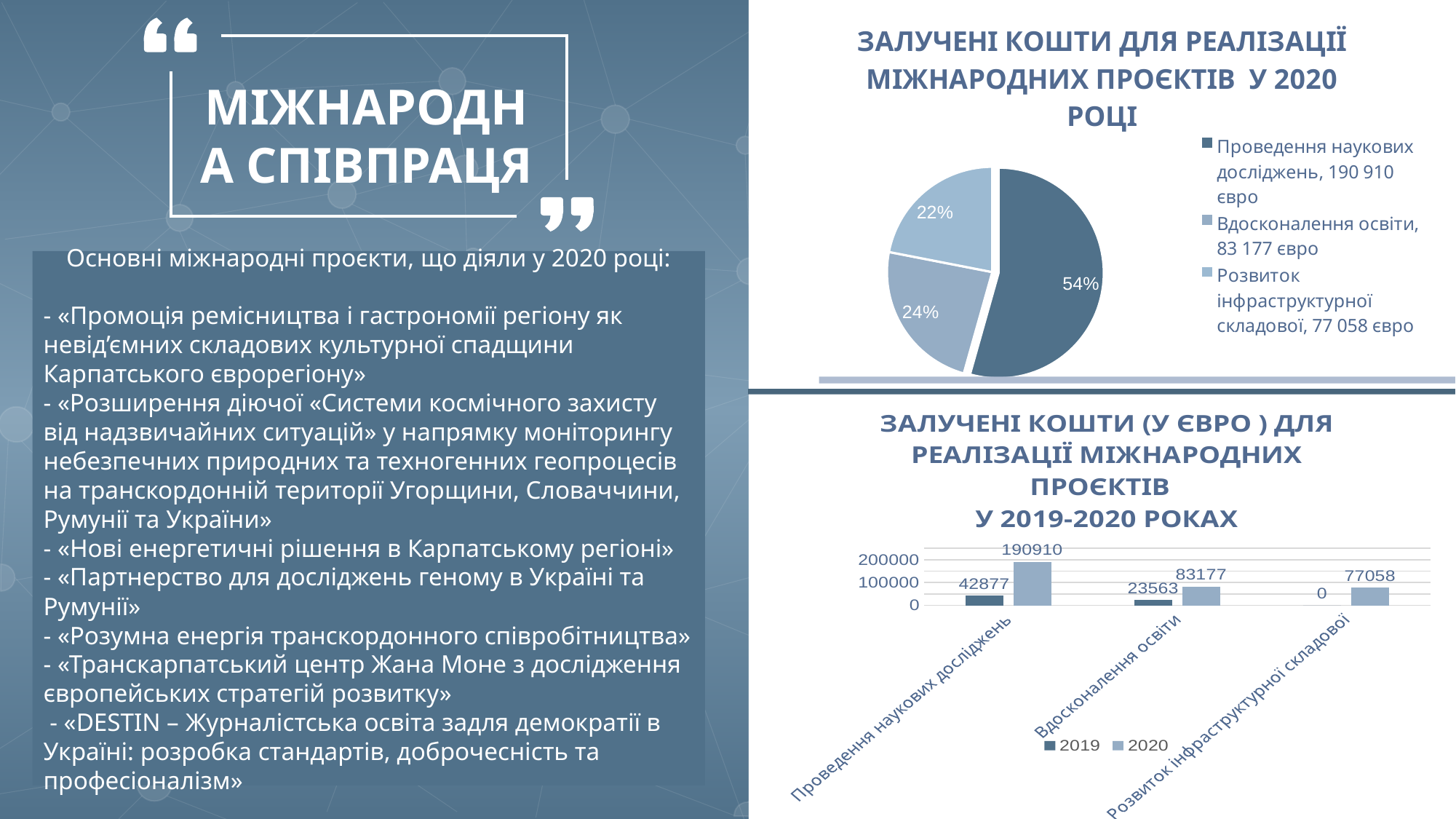
In the pie chart at the top right, what amount in euros does the legend give for 'Вдосконалення освіти'? 83 177 євро In the pie chart at the top right, which category has the largest slice? Проведення наукових досліджень In the bar chart at the bottom right, what is the difference between the 2020 and 2019 values for 'Проведення наукових досліджень'? 148033 In the bar chart at the bottom right, how many series does the legend list? 2 In the bar chart at the bottom right, which is larger: the 2020 value for 'Вдосконалення освіти' or the 2020 value for 'Розвиток інфраструктурної складової'? Вдосконалення освіти In the pie chart at the top right, what share of the funds goes to 'Проведення наукових досліджень'? 54% In the pie chart at the top right, what share of the funds goes to 'Розвиток інфраструктурної складової'? 22% What type of chart is shown at the bottom right of the slide? Bar chart In the pie chart at the top right, how many slices does the pie have? 3 In the bar chart at the bottom right, what is the 2020 value for 'Проведення наукових досліджень'? 190910 In the bar chart at the bottom right, what is the 2019 value for 'Вдосконалення освіти'? 23563 In the bar chart at the bottom right, what is the 2019 value for 'Розвиток інфраструктурної складової'? 0